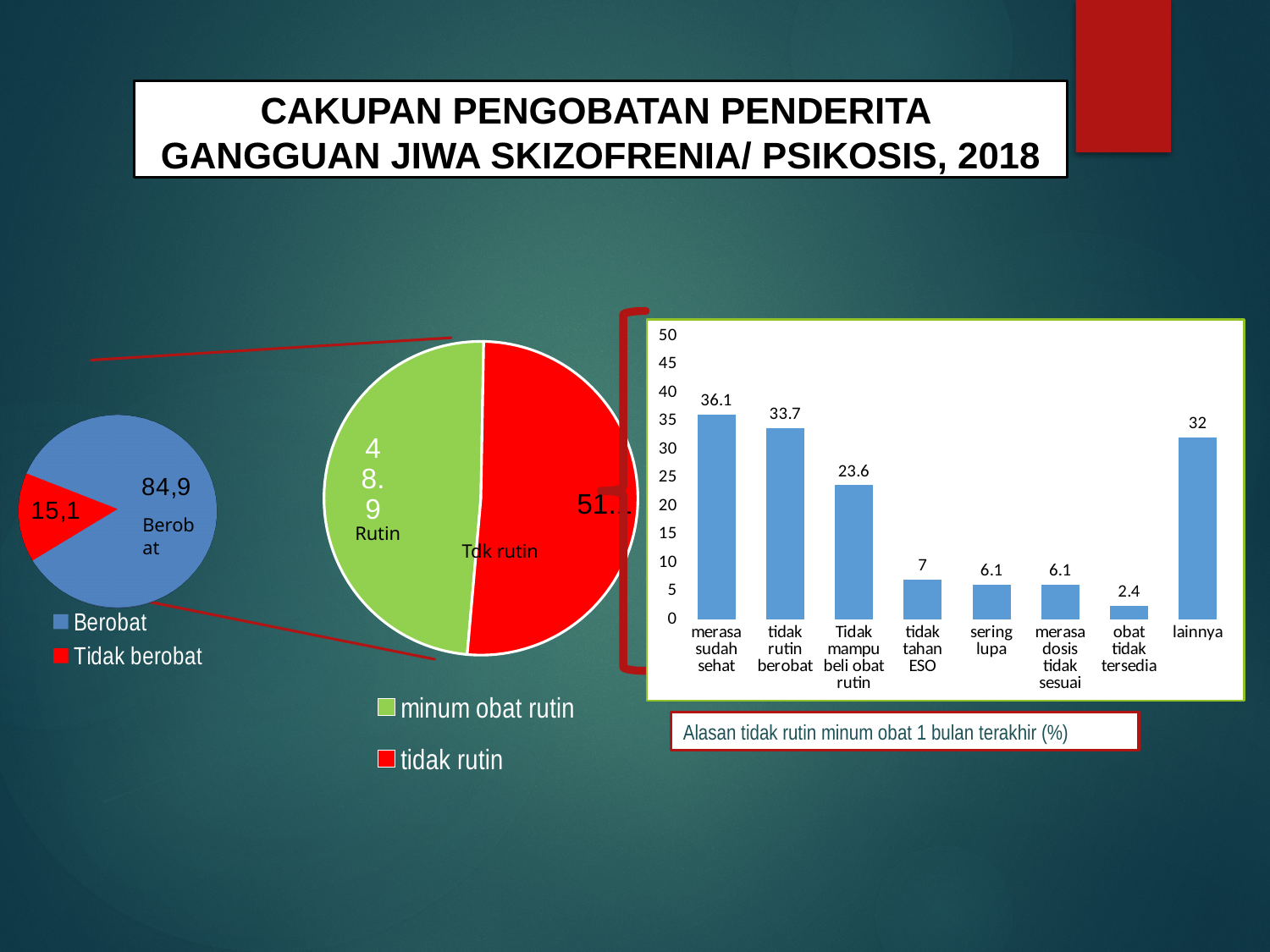
In the pie chart on the left, what is the value for 'Tidak berobat'? 15,1 In the bar chart on the right, what is the value for 'merasa sudah sehat'? 36.1 What kind of chart is the chart on the right of the slide? bar chart What caption is shown below the bar chart on the right? Alasan tidak rutin minum obat 1 bulan terakhir (%) In the bar chart on the right, what is the value for 'lainnya'? 32 In the pie chart on the left, what is the value for 'Berobat'? 84,9 How many categories are shown in the bar chart on the right? 8 In the bar chart on the right, which category has the highest value? merasa sudah sehat In the bar chart on the right, what is the difference between 'tidak rutin berobat' and 'Tidak mampu beli obat rutin'? 10.1 In the bar chart on the right, what is the value for 'obat tidak tersedia'? 2.4 In the bar chart on the right, which category has the lowest value? obat tidak tersedia In the bar chart on the right, which is larger: 'tidak tahan ESO' or 'sering lupa'? tidak tahan ESO